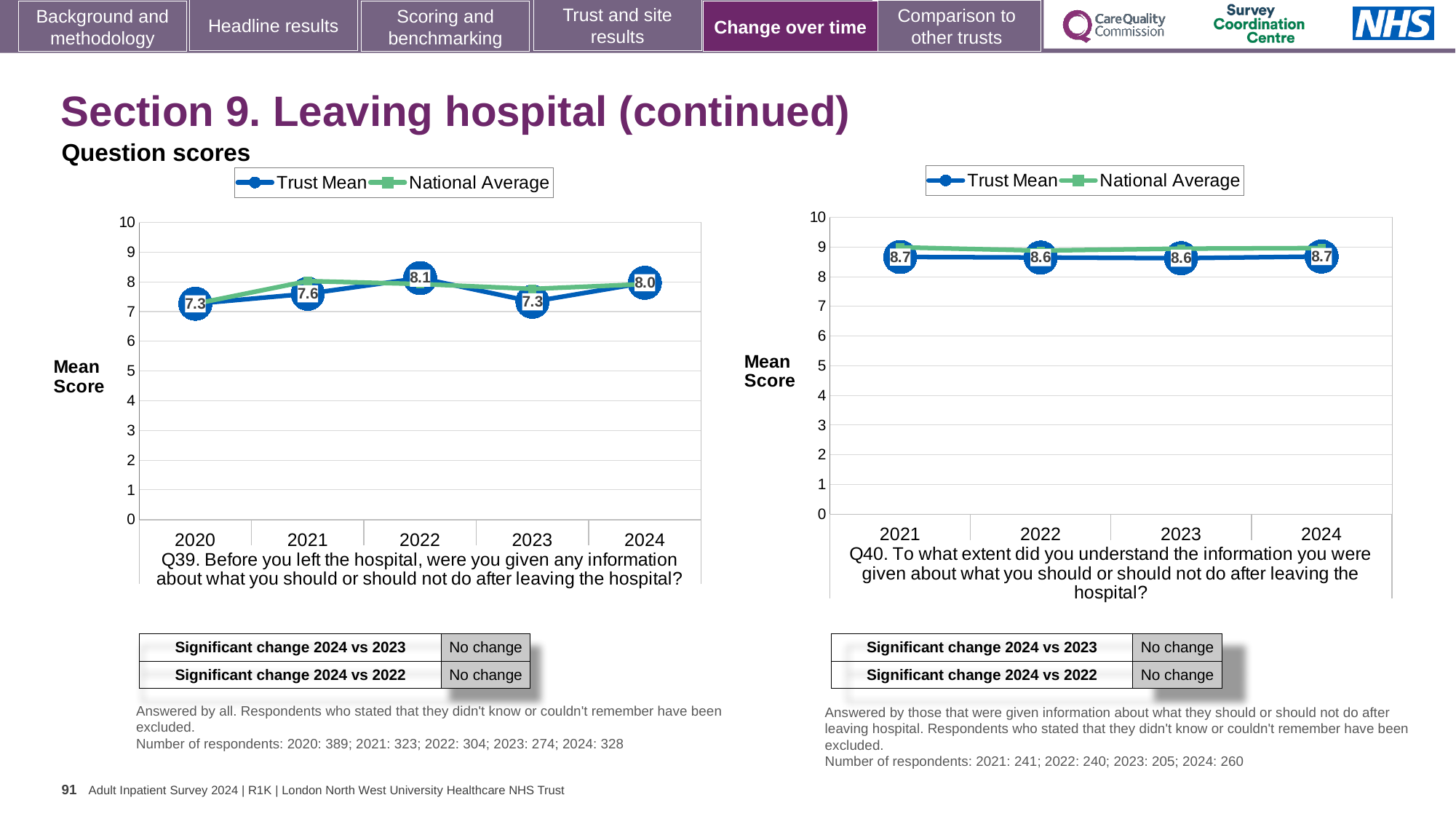
In the Q39 chart on the left, what is the Trust Mean score for 2024? 8.0 In the Q40 chart on the right, what is the difference between the Trust Mean scores for 2024 and 2023? 0.1 How many series does the legend of the Q40 chart on the right list? 2 In the Q39 chart on the left, what is the difference between the Trust Mean scores for 2022 and 2023? 0.8 In the Q40 chart on the right, is the National Average value for 2021 greater or less than 8? greater What kind of chart is the Q39 chart on the left? Line chart In the Q39 chart on the left, is the Trust Mean score higher in 2021 or in 2023? 2021 In the Q39 chart on the left, is the National Average value for 2021 greater or less than 7? greater In the Q40 chart on the right, what is the Trust Mean score for 2021? 8.7 In the Q39 chart on the left, which year has the highest Trust Mean score? 2022 In the Q39 chart on the left, what is the Trust Mean score for 2022? 8.1 How many years are plotted on the x axis of the Q39 chart on the left? 5